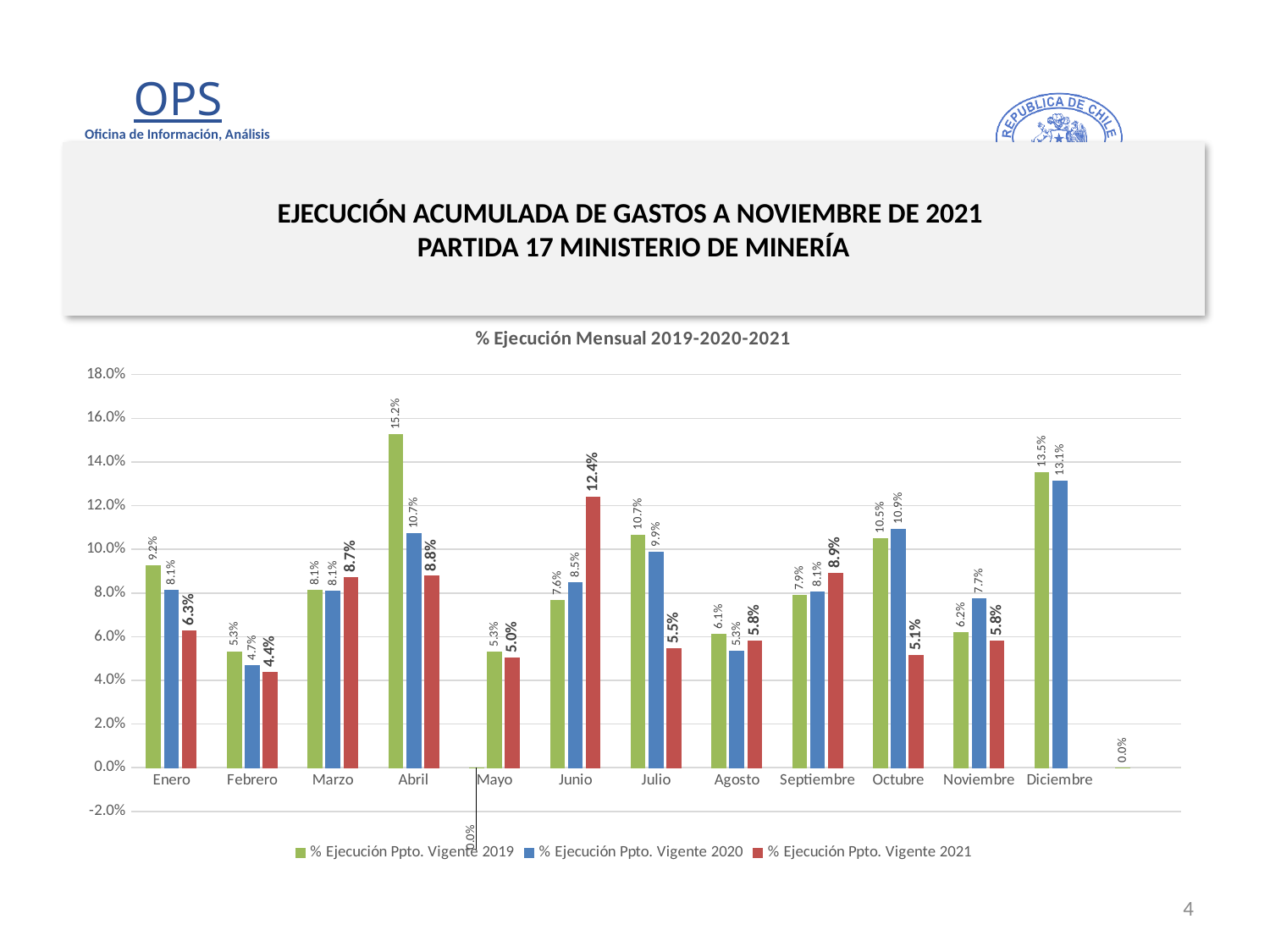
Which month has the highest value for % Ejecución Ppto. Vigente 2021? Junio What is the value for % Ejecución Ppto. Vigente 2020 in Diciembre? 13.1% What is the difference between the 2019 and 2020 values in Abril? 4.5 percentage points What kind of chart is shown on the slide? Bar chart How many series does the legend list? 3 In Octubre, which series has the larger value: % Ejecución Ppto. Vigente 2019 or % Ejecución Ppto. Vigente 2020? % Ejecución Ppto. Vigente 2020 What is the value for % Ejecución Ppto. Vigente 2021 in Junio? 12.4% What is the difference between the 2019 and 2021 values in Julio? 5.2 percentage points Which month has the highest value for % Ejecución Ppto. Vigente 2019? Abril What is the value for % Ejecución Ppto. Vigente 2019 in Abril? 15.2% Which month has the lowest value for % Ejecución Ppto. Vigente 2020? Febrero How many months are shown on the x axis of the chart? 12